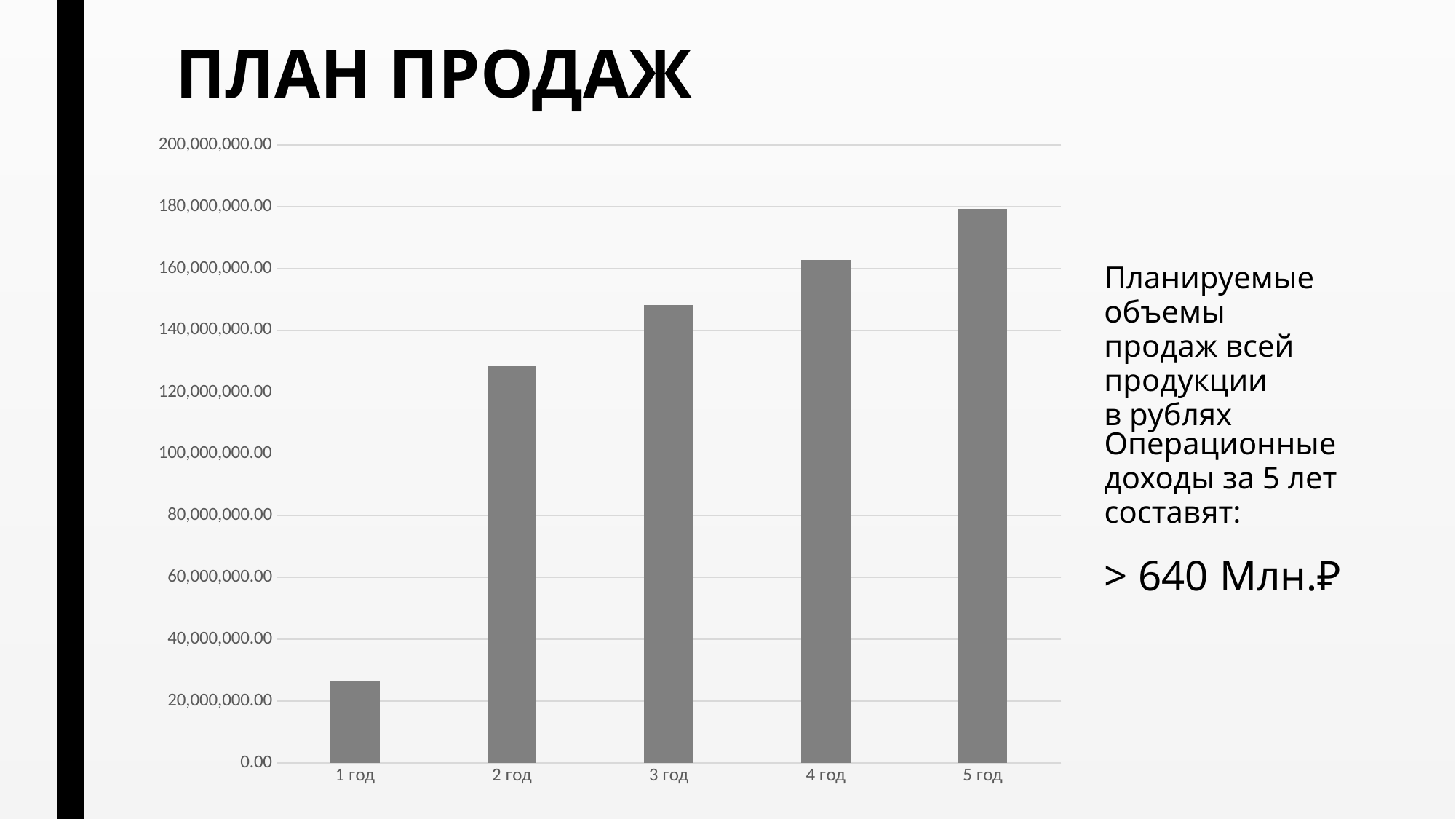
Which is larger, the value for 2 год or the value for 4 год? 4 год Do the values rise or fall from 1 год to 5 год? rise Which year has the highest planned sales value? 5 год Is the value for 4 год greater or less than 160,000,000.00? greater Is the value for 3 год greater or less than 160,000,000.00? less How many categories (years) are plotted on the chart? 5 Which year has the lowest planned sales value? 1 год What kind of chart is shown on the slide? bar chart Is the value for 2 год greater or less than 120,000,000.00? greater What is the title of the slide containing the chart? ПЛАН ПРОДАЖ